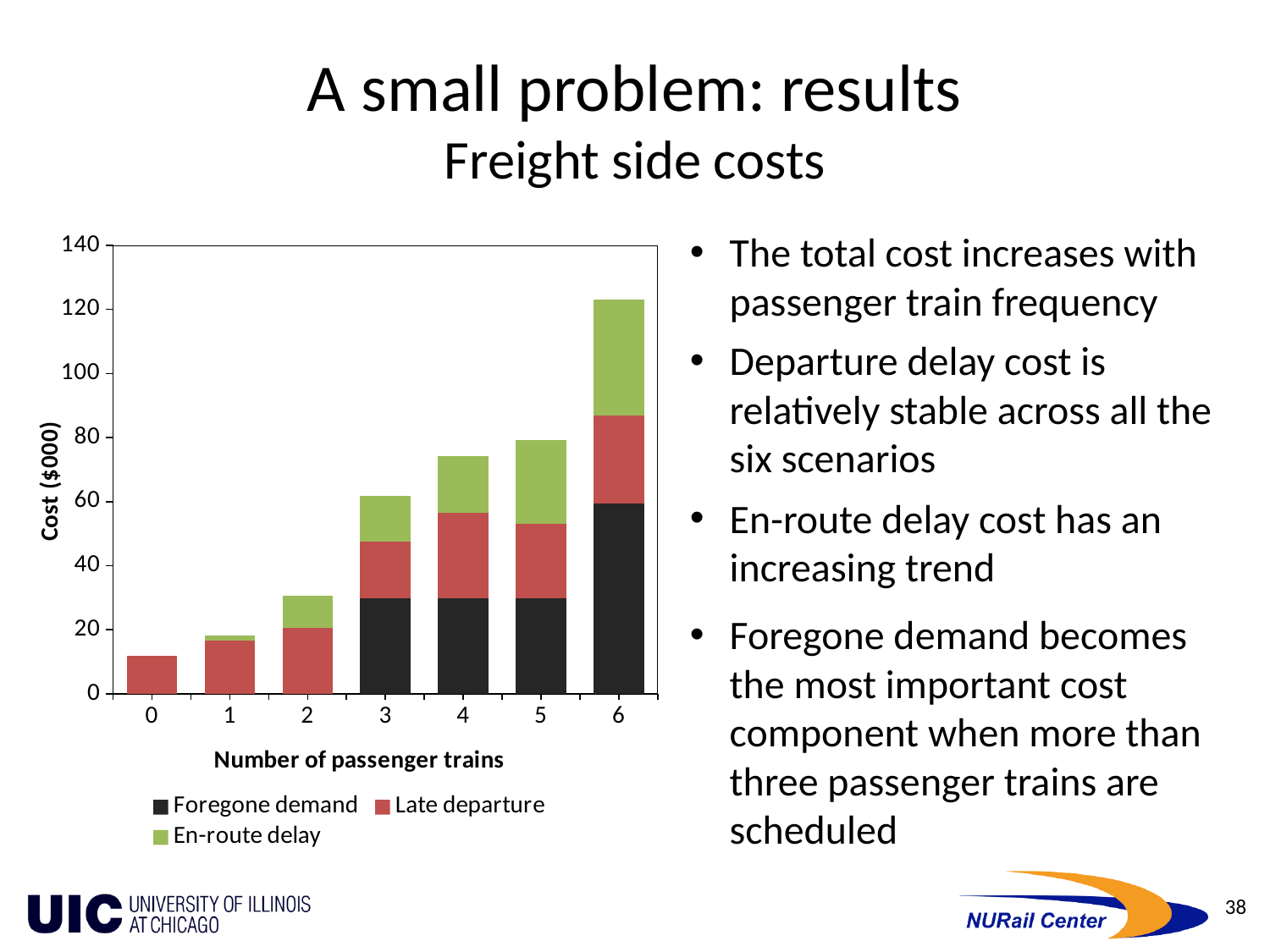
Is the total cost for 0 passenger trains greater or less than 20? less Is the total cost for 4 passenger trains greater or less than 60? greater Is the total cost for 6 passenger trains greater or less than 100? greater How many series does the legend list? 3 What kind of chart is shown on the slide? Stacked bar chart Which number of passenger trains has the lowest total cost? 0 Which number of passenger trains has the highest total cost? 6 Does the total cost rise or fall as the number of passenger trains increases? Rises Which has a larger total cost: 4 passenger trains or 2 passenger trains? 4 passenger trains What is the label of the y axis? Cost ($000) How many categories (numbers of passenger trains) are shown on the x axis? 7